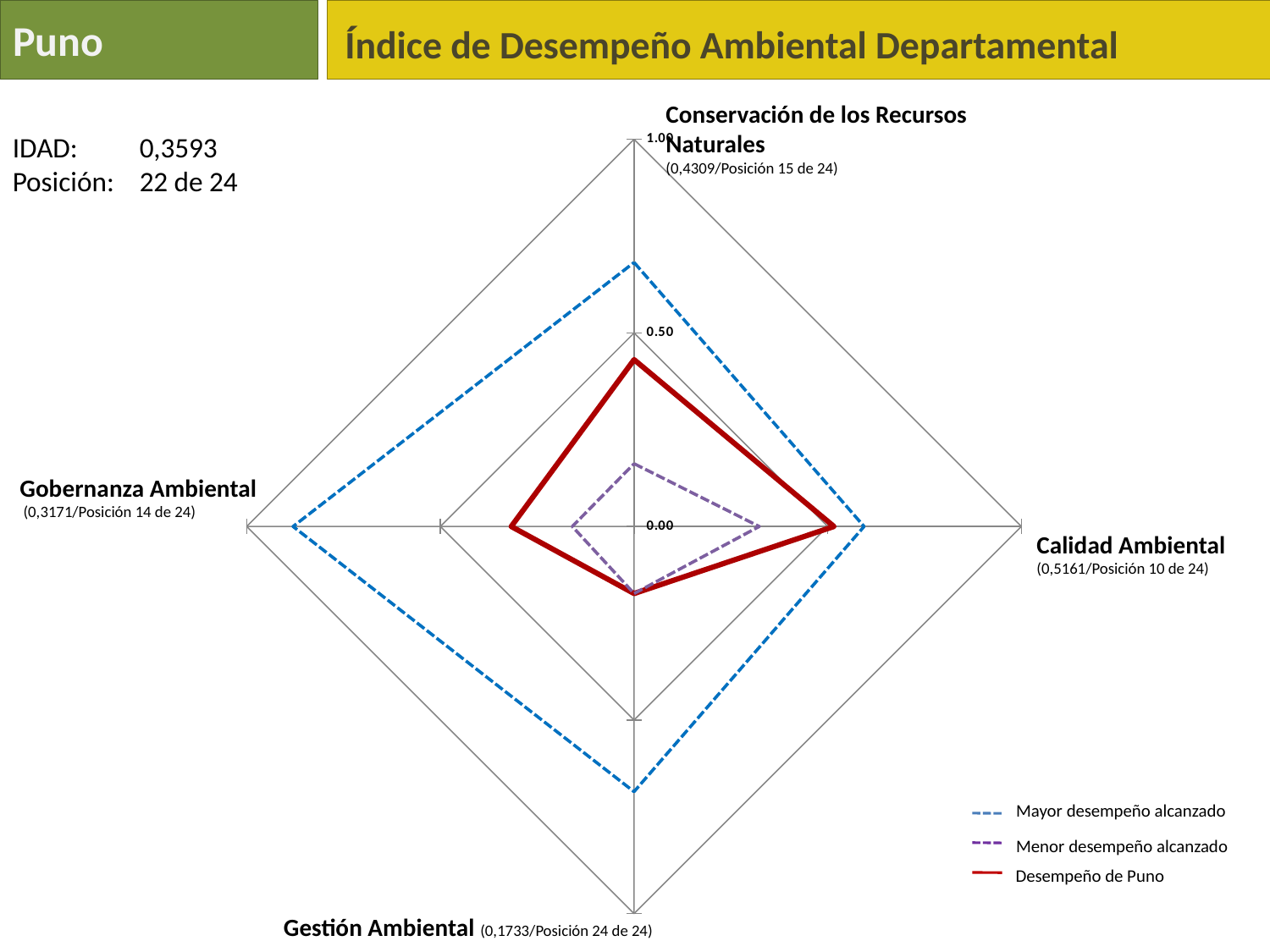
What is Puno's value for Conservación de los Recursos Naturales? 0,4309 What kind of chart is shown on the slide? radar chart How many axes (categories) does the radar chart have? 4 What is Puno's value for Calidad Ambiental? 0,5161 Is Puno's value for Calidad Ambiental greater or less than 0.50? greater What is Puno's value for Gestión Ambiental? 0,1733 On which axis does Puno have its lowest value? Gestión Ambiental What is Puno's value for Gobernanza Ambiental? 0,3171 Which is larger for Puno: Conservación de los Recursos Naturales or Gobernanza Ambiental? Conservación de los Recursos Naturales On which axis does Puno have its highest value? Calidad Ambiental Which legend entry is drawn as a solid red line? Desempeño de Puno How many series does the legend list? 3